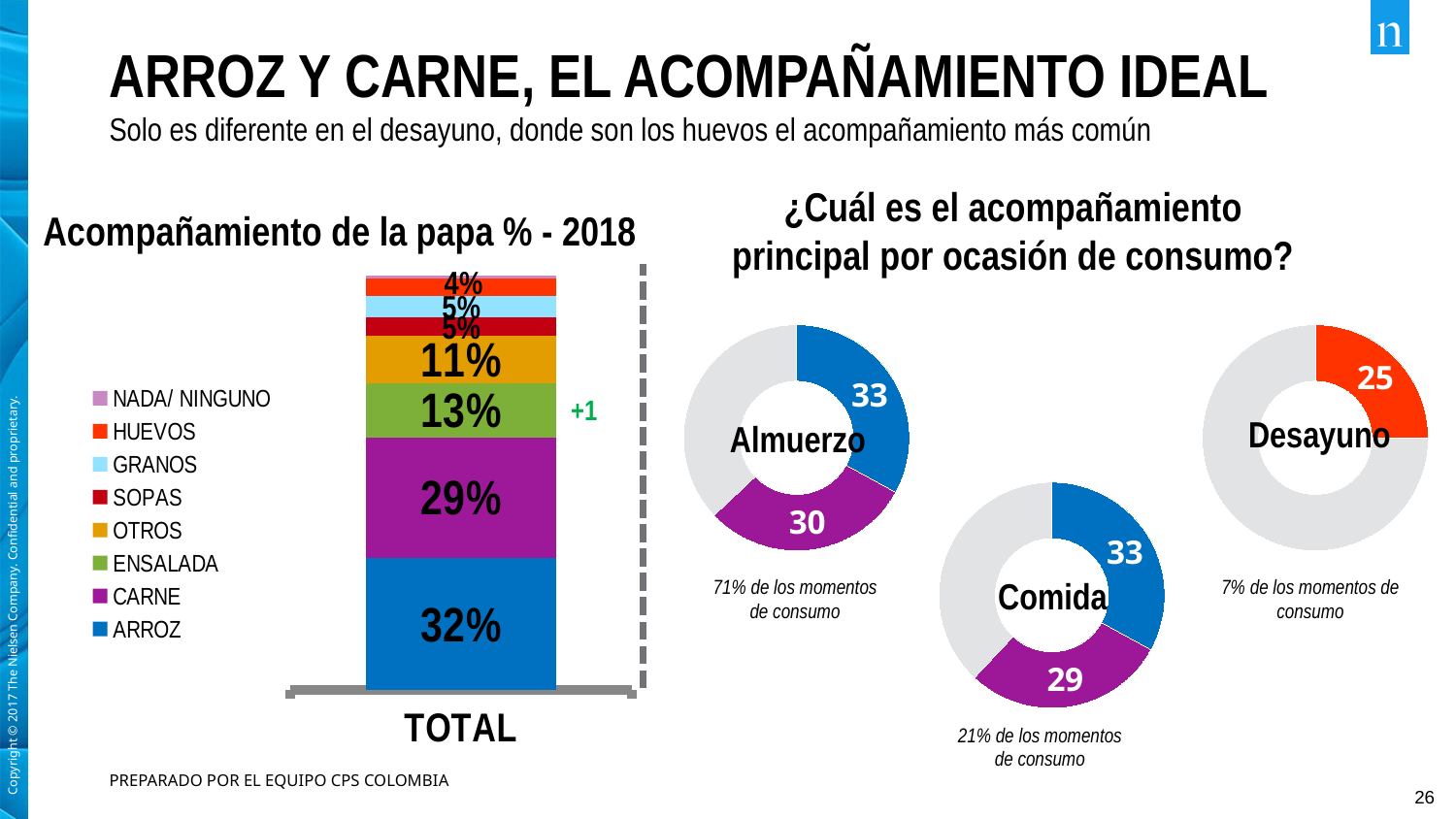
In the 'Almuerzo' donut chart, what value is shown on the blue segment? 33 In the 'Comida' donut chart, what value is shown on the purple segment? 29 In the 'Acompañamiento de la papa % - 2018' stacked bar chart, which category has the largest segment? ARROZ In the 'Acompañamiento de la papa % - 2018' stacked bar chart, what is the value for ARROZ? 32% How many entries does the legend of the 'Acompañamiento de la papa % - 2018' chart list? 8 In the 'Acompañamiento de la papa % - 2018' stacked bar chart, what is the difference between the ARROZ and CARNE values? 3% In the 'Acompañamiento de la papa % - 2018' stacked bar chart, what is the value for OTROS? 11% In the 'Acompañamiento de la papa % - 2018' stacked bar chart, what is the value for CARNE? 29% What kind of chart is 'Acompañamiento de la papa % - 2018'? Stacked bar chart In the 'Acompañamiento de la papa % - 2018' stacked bar chart, which is larger, ENSALADA or OTROS? ENSALADA In the 'Desayuno' donut chart, what value is shown on the red segment? 25 In the 'Acompañamiento de la papa % - 2018' stacked bar chart, what is the value for ENSALADA? 13%